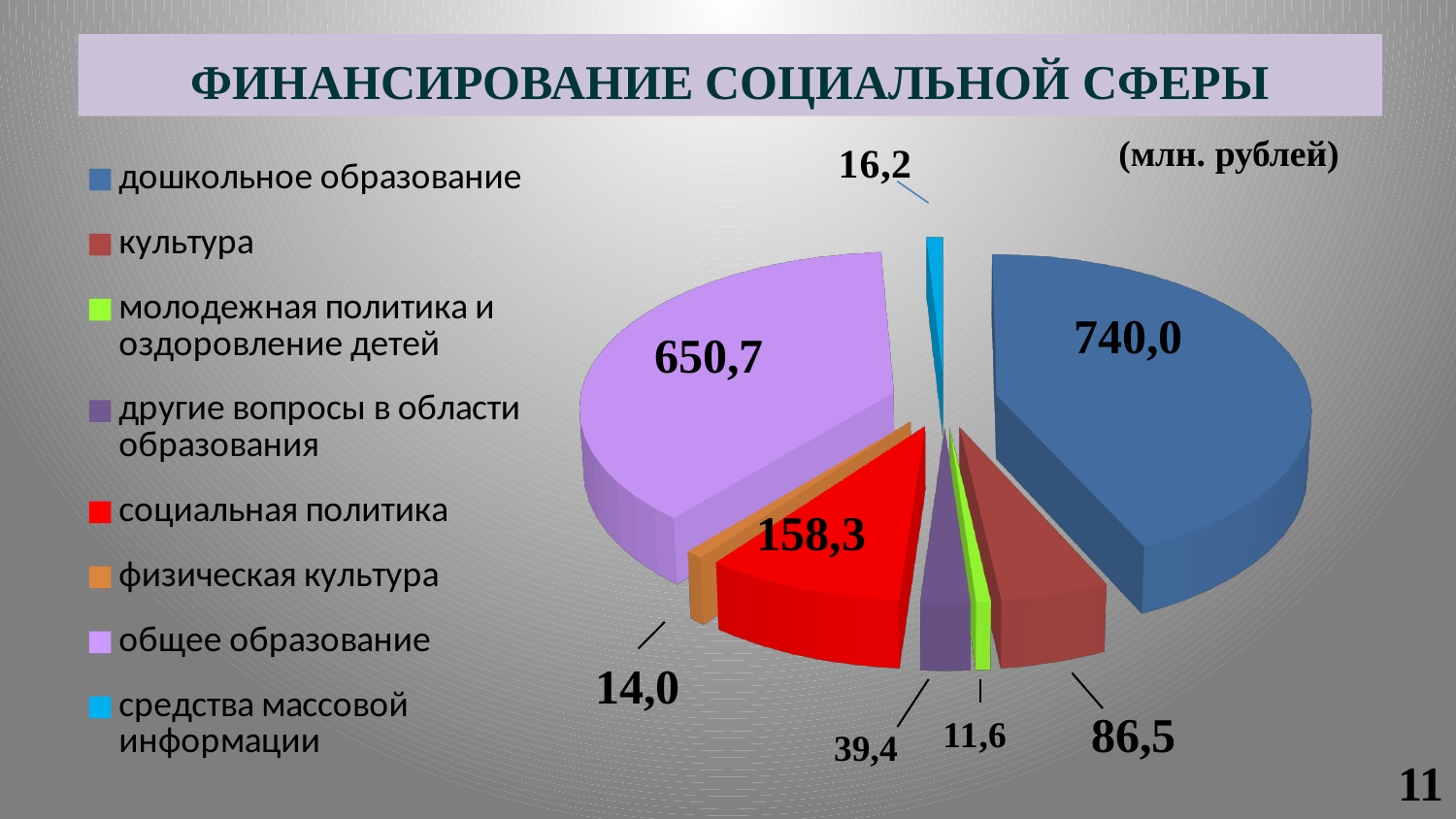
What is the difference between the values for социальная политика and культура? 71,8 Which category has the smallest slice of the pie? молодежная политика и оздоровление детей What is the difference between the values for дошкольное образование and общее образование? 89,3 What kind of chart is shown on the slide? pie chart What is the value for средства массовой информации? 16,2 What is the value for общее образование? 650,7 Which is larger, the value for другие вопросы в области образования or the value for физическая культура? другие вопросы в области образования How many categories does the pie chart have? 8 What unit is stated for the values in the chart? млн. рублей What is the value for социальная политика? 158,3 What is the value for дошкольное образование? 740,0 Which category has the largest slice of the pie? дошкольное образование